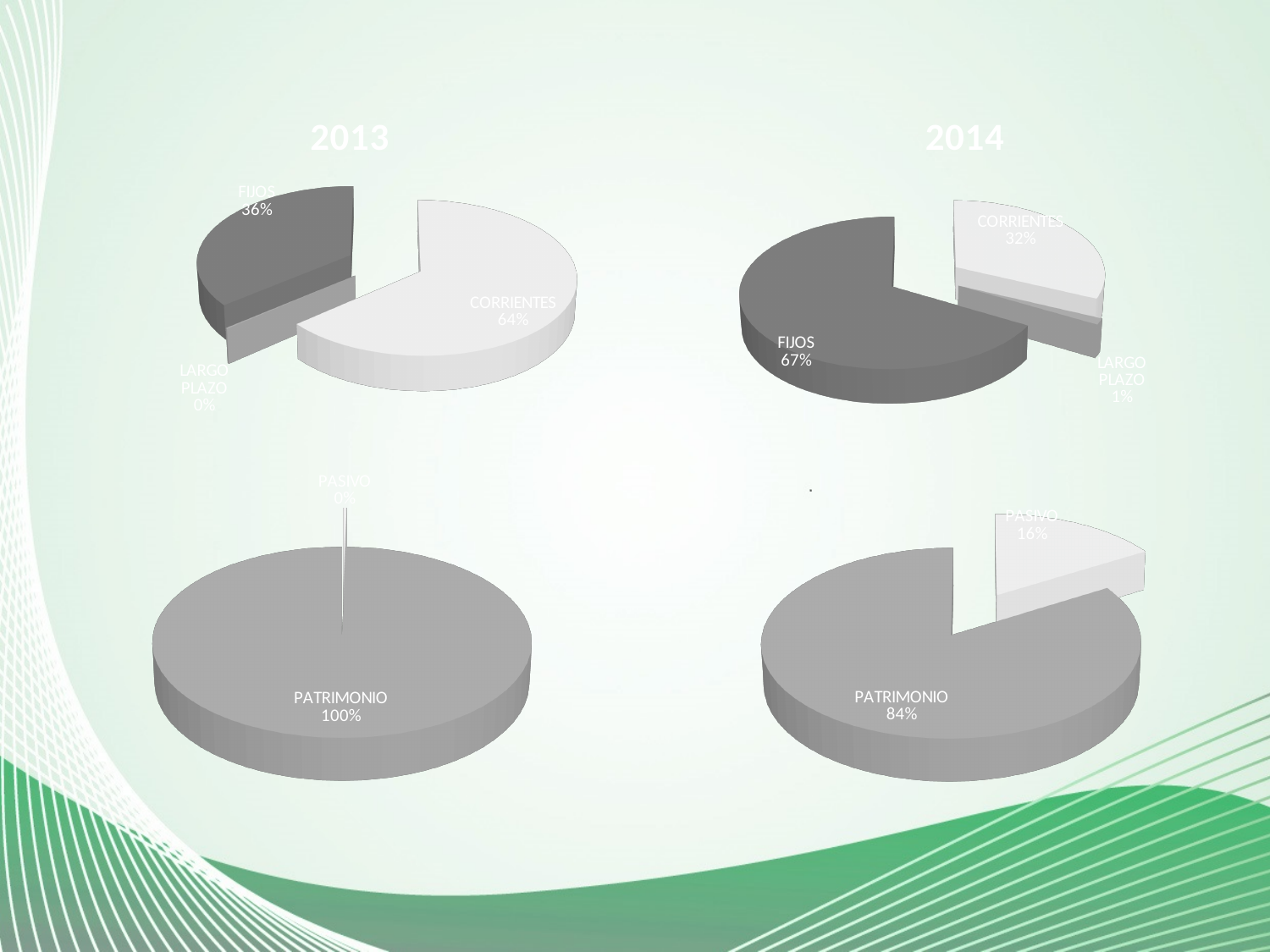
In the bottom-left chart, what share does PATRIMONIO have? 100% How many slices are labelled in the top-left chart titled 2013? 3 In the top-left chart titled 2013, what share does FIJOS have? 36% In the top-right chart titled 2014, what share does LARGO PLAZO have? 1% In the top-left chart titled 2013, which category has the largest slice? CORRIENTES In the bottom-right chart, which is larger, PATRIMONIO or PASIVO? PATRIMONIO In the top-right chart titled 2014, which category has the smallest slice? LARGO PLAZO What kind of chart is the bottom-right chart? Pie chart In the top-right chart titled 2014, what is the difference between the FIJOS and CORRIENTES shares? 35%